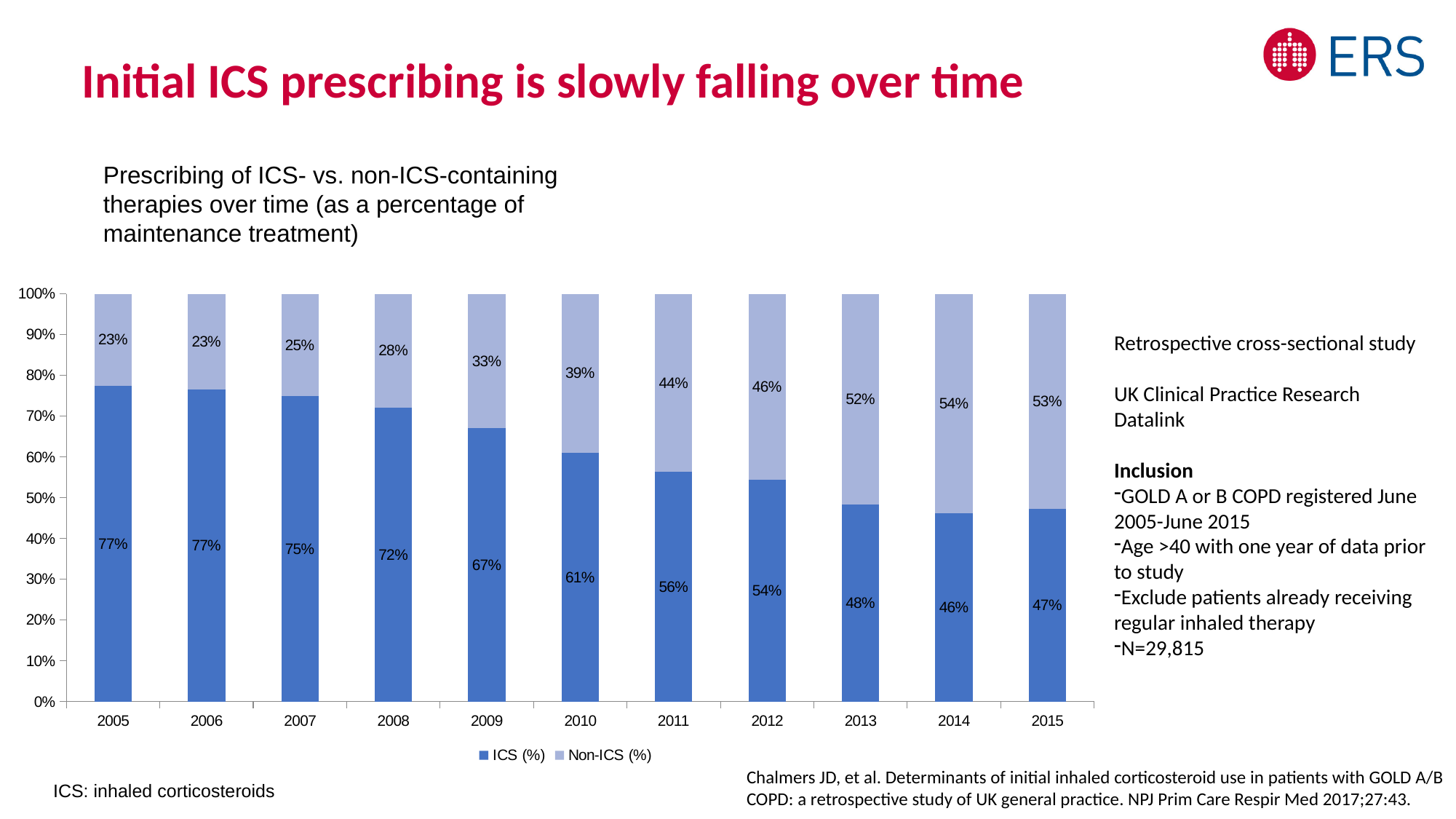
What is the Non-ICS (%) value for 2010? 39% Is the ICS (%) value larger in 2009 or in 2012? 2009 Which year has the highest Non-ICS (%) value? 2014 What is the total of the stacked bar for 2008? 100% Which year has the lowest ICS (%) value? 2014 What is the difference between the ICS (%) value in 2005 and in 2015? 30% How many series does the legend list? 2 What kind of chart is shown on the slide? Stacked bar chart How many years are shown on the x axis? 11 What is the ICS (%) value for 2013? 48% Does the ICS (%) value rise or fall from 2005 to 2015? Fall What is the ICS (%) value for 2005? 77%